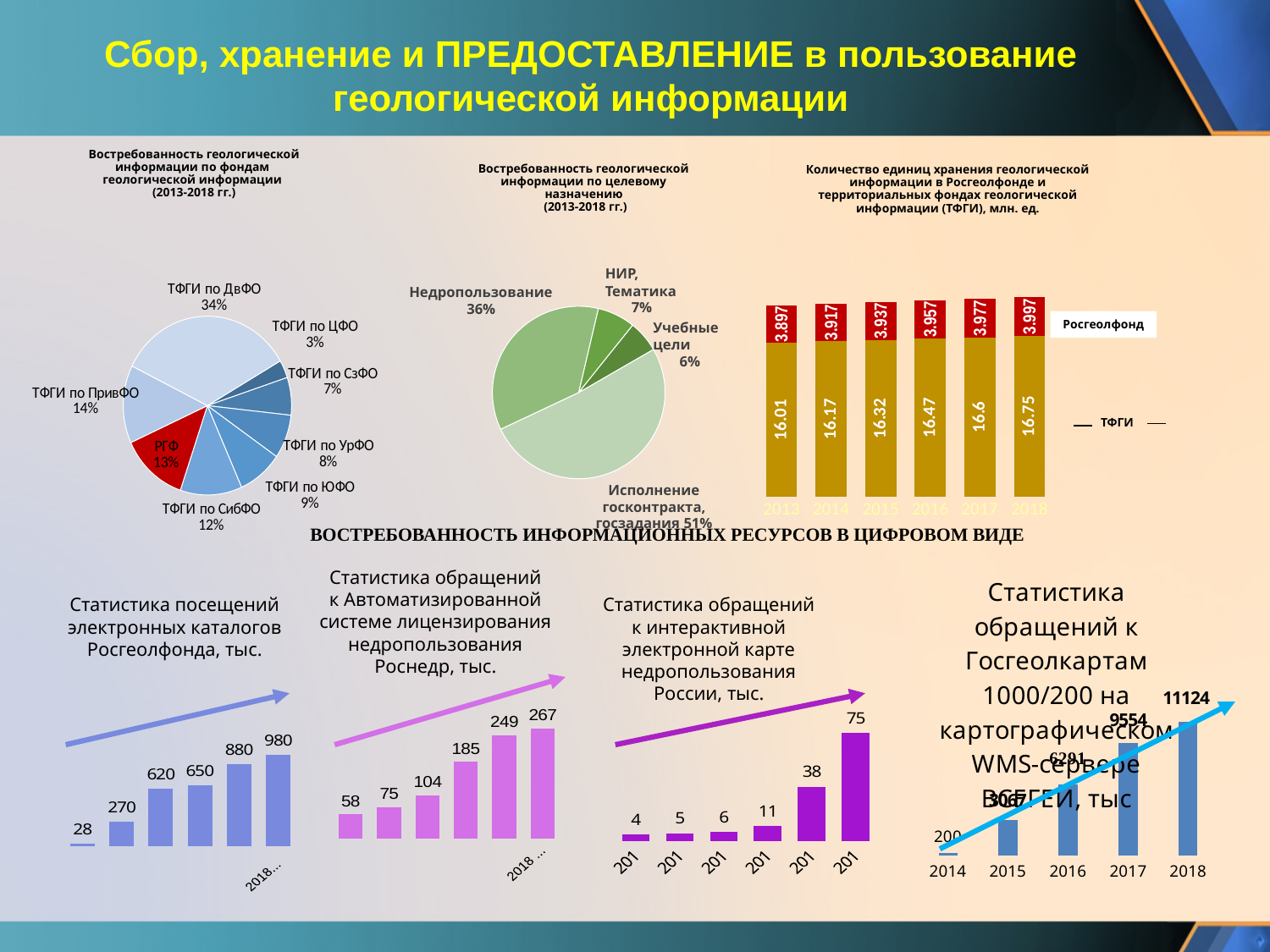
In the pie chart 'Востребованность геологической информации по фондам геологической информации (2013-2018 гг.)', how many slices are there? 8 In the pie chart 'Востребованность геологической информации по фондам геологической информации (2013-2018 гг.)', which slice is the smallest? ТФГИ по ЦФО In the chart 'Статистика обращений к интерактивной электронной карте недропользования России, тыс.', do the values rise or fall from left to right? rise In the stacked bar chart 'Количество единиц хранения геологической информации...', what is the ТФГИ value for 2015? 16.32 In the chart 'Статистика обращений к Госгеолкартам 1000/200 на картографическом WMS-сервере ВСЕГЕИ, тыс', what is the value for 2018? 11124 In the chart 'Статистика посещений электронных каталогов Росгеолфонда, тыс.', what is the highest value shown? 980 In the pie chart 'Востребованность геологической информации по целевому назначению (2013-2018 гг.)', what share is Исполнение госконтракта, госзадания? 51% In the stacked bar chart 'Количество единиц хранения геологической информации...', how many series does the legend list? 2 In the stacked bar chart 'Количество единиц хранения геологической информации...', what is the Росгеолфонд value for 2018? 3.997 In the chart 'Статистика обращений к Автоматизированной системе лицензирования недропользования Роснедр, тыс.', what is the difference between the last bar (267) and the first bar (58)? 209 In the pie chart 'Востребованность геологической информации по фондам геологической информации (2013-2018 гг.)', what share does ТФГИ по ДвФО have? 34% In the pie chart 'Востребованность геологической информации по целевому назначению (2013-2018 гг.)', what is the difference between Недропользование and Учебные цели? 30%